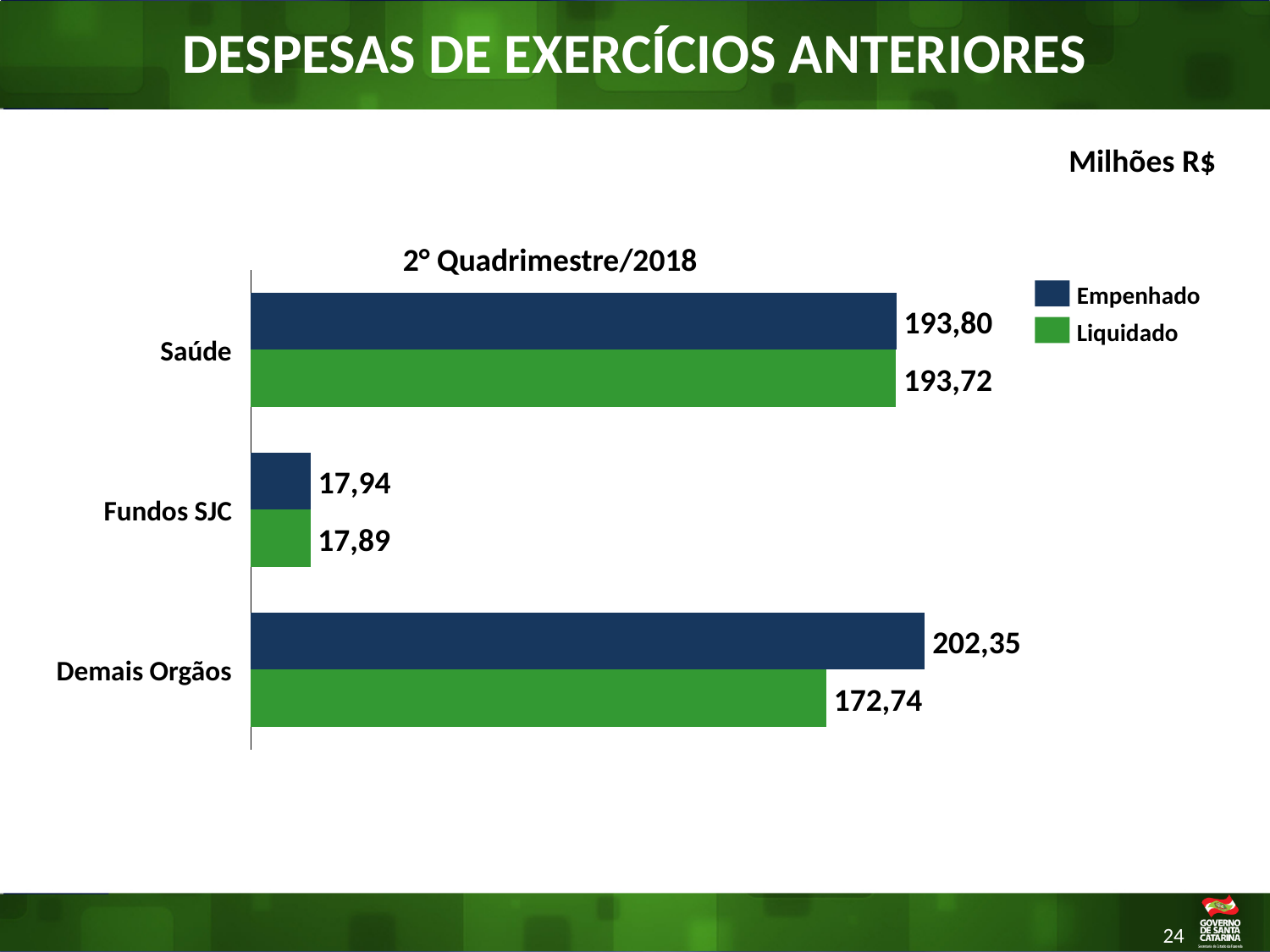
What is the Liquidado value for Demais Orgãos? 172,74 How many categories are shown in the chart? 3 What kind of chart is shown on the slide? Bar chart Which category has the lowest Liquidado value? Fundos SJC What is the Empenhado value for Saúde? 193,80 What is the title of the chart? 2º Quadrimestre/2018 What is the Empenhado value for Demais Orgãos? 202,35 Which category has the highest Empenhado value? Demais Orgãos How many series does the legend list? 2 What is the Liquidado value for Fundos SJC? 17,89 Which is larger for Demais Orgãos, the Empenhado value or the Liquidado value? Empenhado What is the difference between the Empenhado and Liquidado values for Demais Orgãos? 29,61